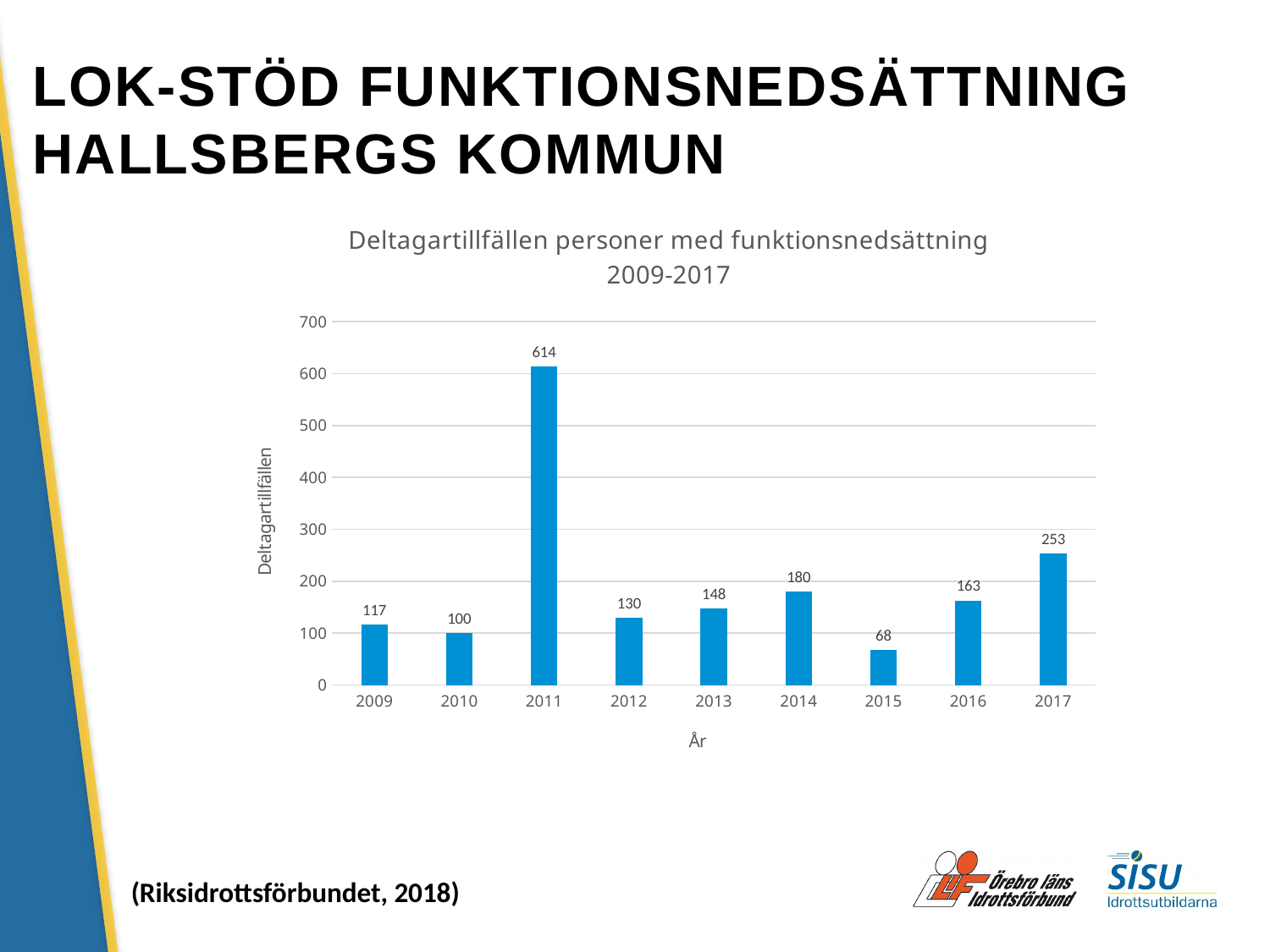
Do the values rise or fall from 2015 to 2017? rise Which is larger, the value for 2009 or the value for 2010? 2009 Which year has the highest value? 2011 What is the value for 2011? 614 What is the label of the y axis? Deltagartillfällen What is the difference between the values for 2017 and 2016? 90 Which year has the lowest value? 2015 What kind of chart is shown? bar chart Is the value for 2014 greater or less than 200? less How many years are shown on the x axis? 9 What is the value for 2015? 68 What is the value for 2017? 253